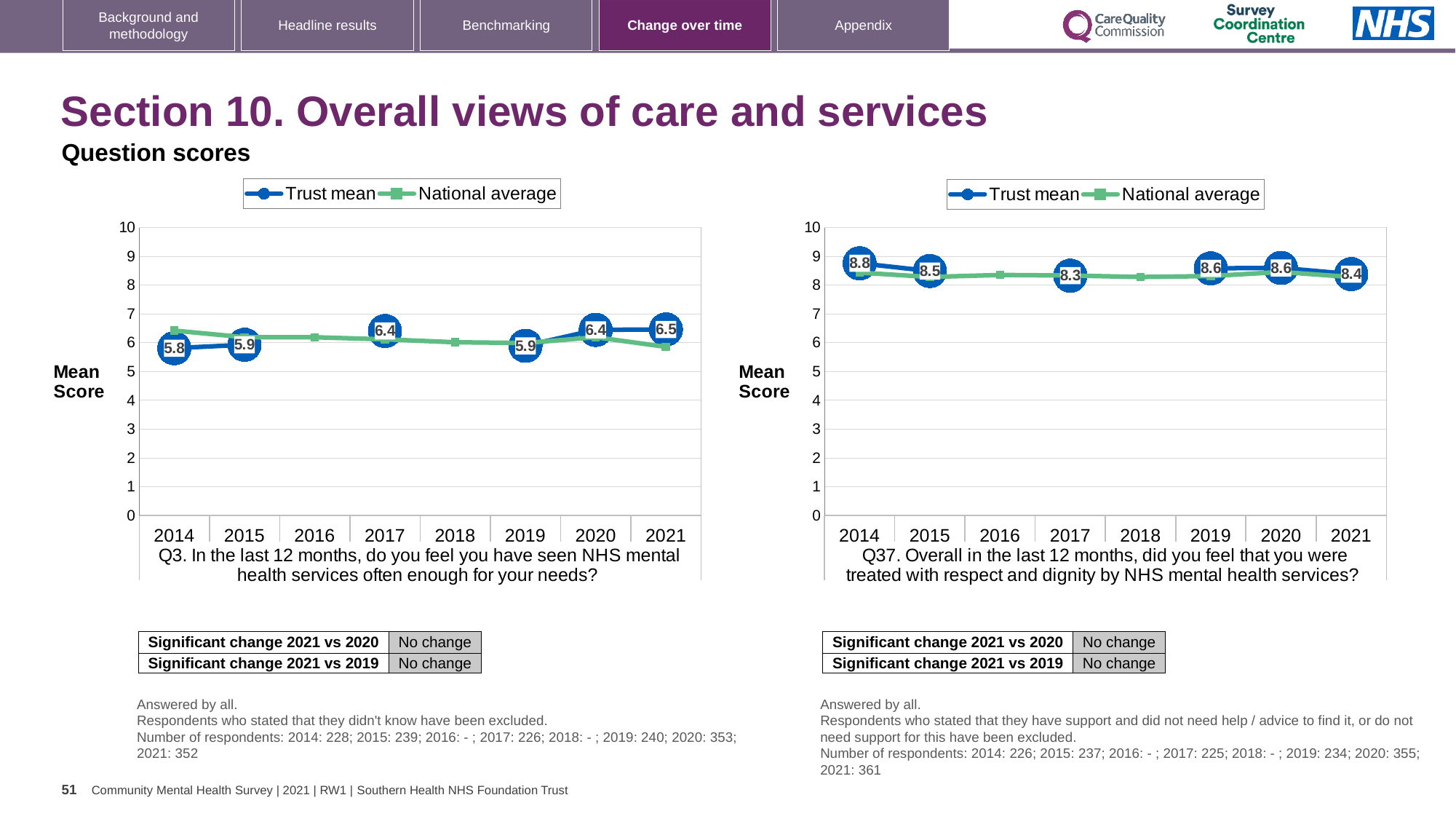
On the Q37 chart (right), what is the Trust mean for 2014? 8.8 On the Q37 chart (right), in which year is the labelled Trust mean lowest? 2017 On the Q3 chart (left), what is the difference between the Trust mean in 2021 and in 2014? 0.7 On the Q3 chart (left), what is the Trust mean for 2021? 6.5 On the Q37 chart (right), which is larger: the Trust mean in 2014 or in 2021? 2014 On the Q3 chart (left), in which year is the labelled Trust mean highest? 2021 What kind of chart is the Q3 chart (left)? Line chart On the Q3 chart (left), what is the Trust mean for 2014? 5.8 How many series does the legend of the Q37 chart (right) list? 2 On the Q37 chart (right), in which year is the labelled Trust mean highest? 2014 On the Q3 chart (left), is the National average for 2021 greater or less than 7? less On the Q37 chart (right), what is the Trust mean for 2021? 8.4